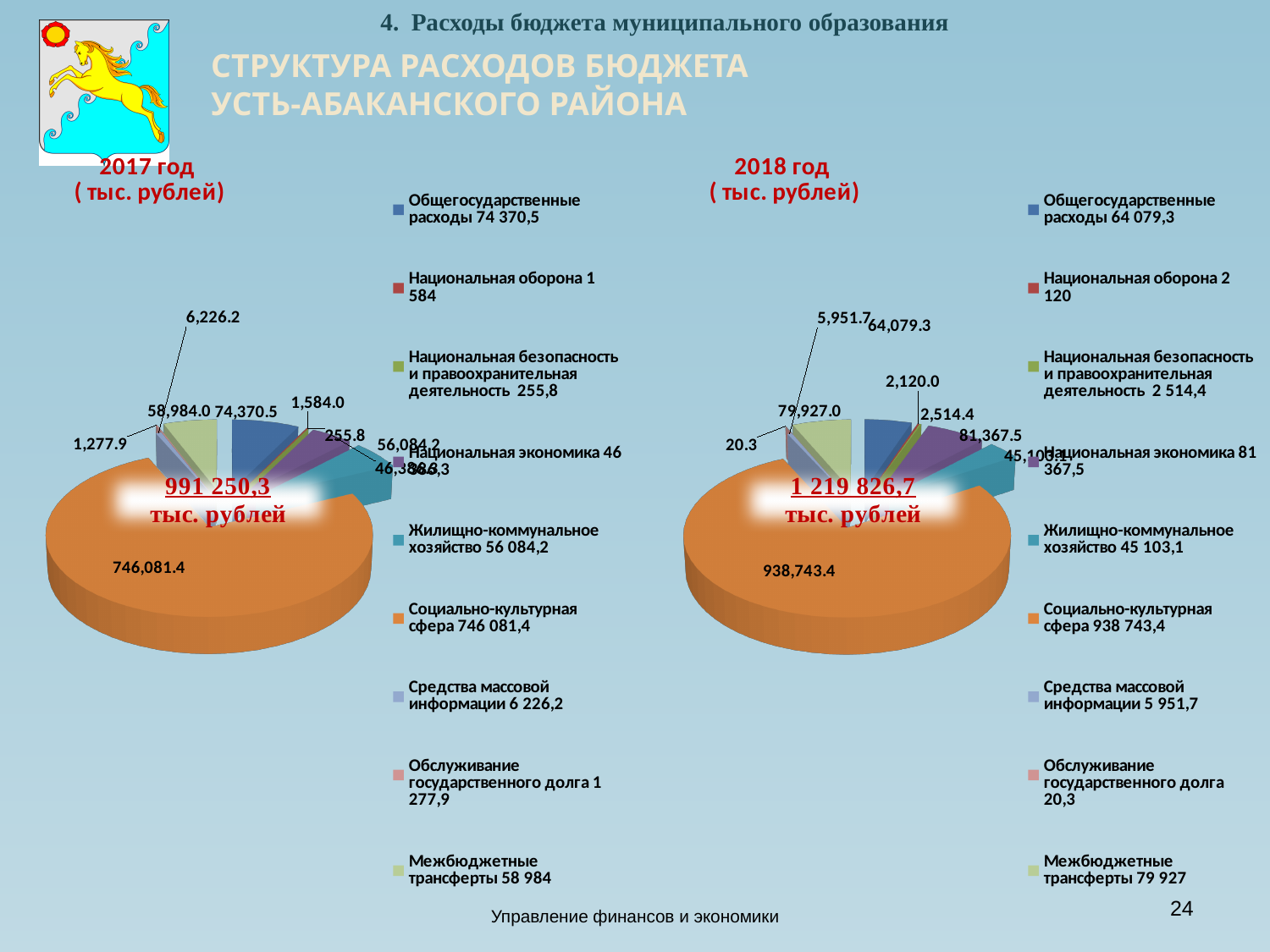
On the 2017 pie chart, which is larger: Общегосударственные расходы or Межбюджетные трансферты? Общегосударственные расходы What type of chart is used for the 2017 budget structure? Pie chart On the 2017 pie chart, what is the value for Социально-культурная сфера? 746,081.4 On the 2017 pie chart, what is the value for Средства массовой информации? 6,226.2 How many categories does the 2018 pie chart show? 9 On the 2018 pie chart, what is the value for Общегосударственные расходы? 64,079.3 On the 2017 pie chart, which category has the largest value? Социально-культурная сфера On the 2018 pie chart, what is the value for Межбюджетные трансферты? 79,927.0 What total is printed on the 2018 pie chart? 1 219 826,7 тыс. рублей On the 2018 pie chart, which category has the smallest value? Обслуживание государственного долга On the 2018 pie chart, what is the difference between Национальная экономика and Межбюджетные трансферты? 1,440.5 What is the difference between the Социально-культурная сфера value on the 2018 chart and on the 2017 chart? 192,662.0